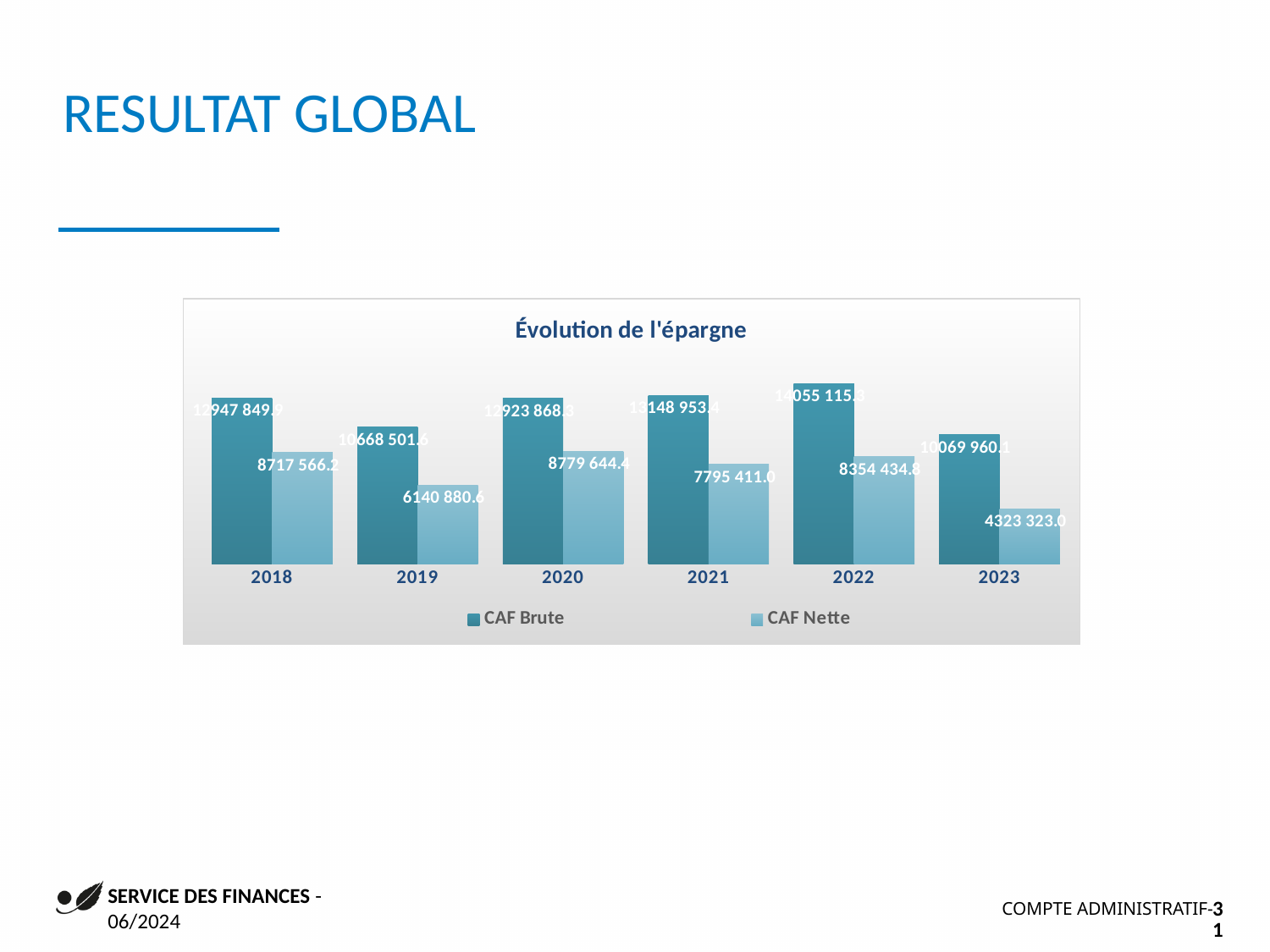
Which is larger, CAF Nette in 2020 or CAF Nette in 2021? CAF Nette in 2020 What is the title of the chart? Évolution de l'épargne How many series does the legend list? 2 In which year is CAF Brute highest? 2022 What is the CAF Nette value for 2022? 8354 434.8 What is the CAF Nette value for 2019? 6140 880.6 What is the CAF Nette value for 2023? 4323 323.0 What is the CAF Brute value for 2019? 10668 501.6 What is the difference between CAF Brute and CAF Nette in 2019? 4527 621.0 What type of chart is shown on the slide? bar chart How many years are shown on the x axis? 6 In which year is CAF Nette lowest? 2023